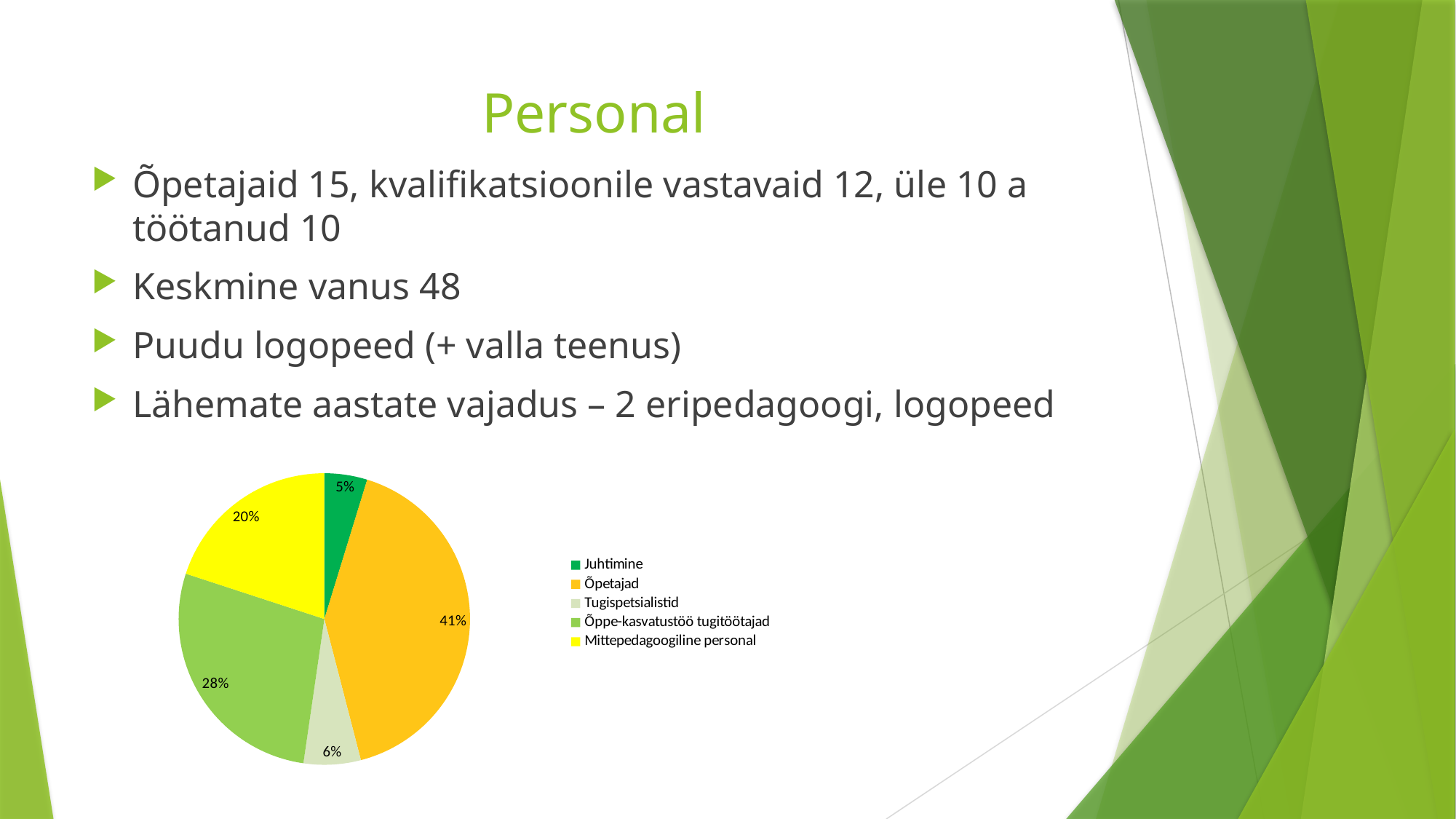
What kind of chart is shown on the slide? pie chart What share of the pie does Juhtimine have? 5% What share of the pie does Tugispetsialistid have? 6% Which category has the smallest slice of the pie? Juhtimine What share of the pie does Õpetajad have? 41% What is the difference in percentage points between Õpetajad and Mittepedagoogiline personal? 21 Which category is shown in yellow in the pie chart? Mittepedagoogiline personal Which category has the largest slice of the pie? Õpetajad How many categories does the pie chart have? 5 Which is larger, the share for Õppe-kasvatustöö tugitöötajad or the share for Mittepedagoogiline personal? Õppe-kasvatustöö tugitöötajad